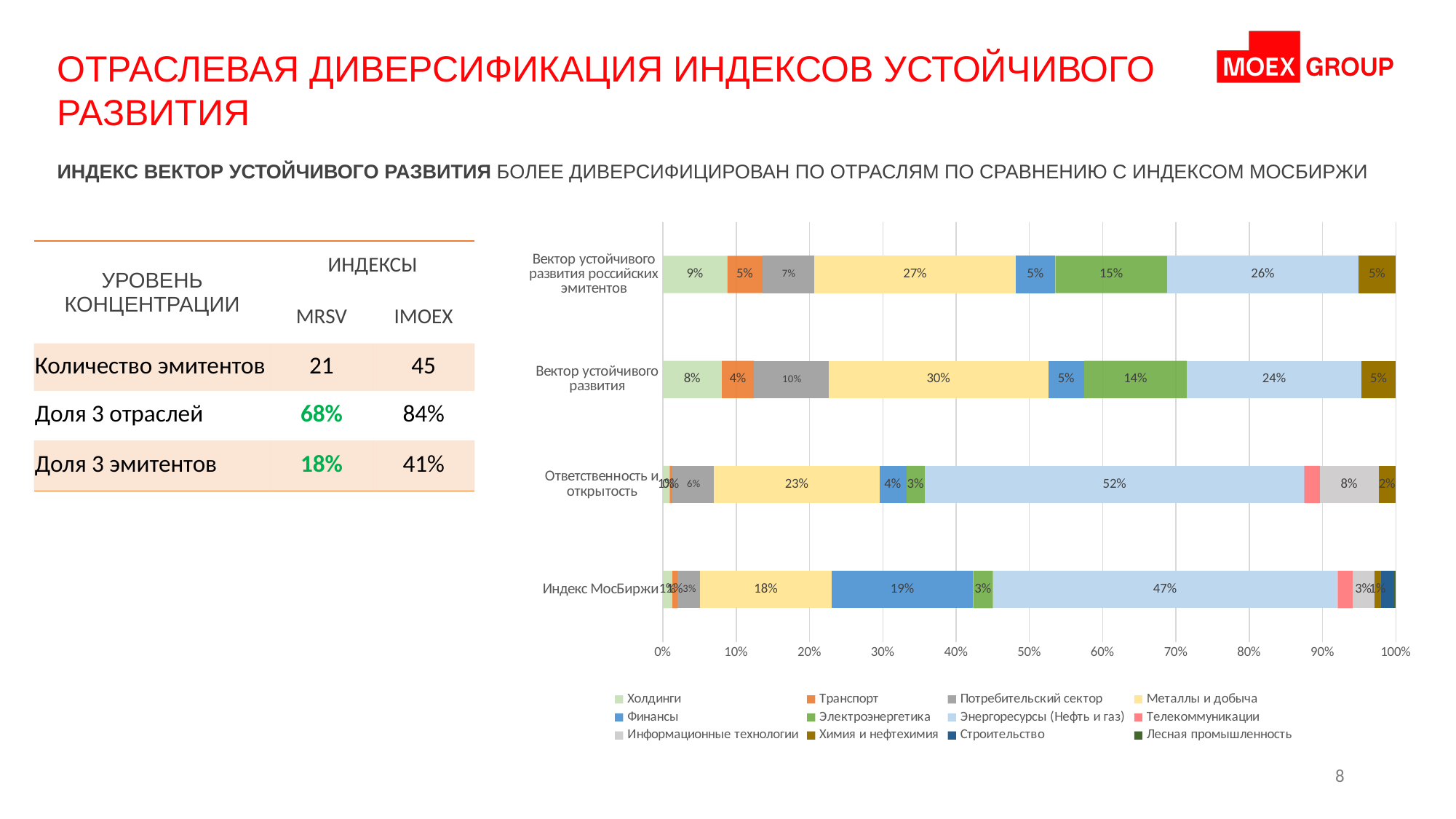
What is the difference between the Финансы share in Индекс МосБиржи and in Вектор устойчивого развития? 14% Which is larger: the Холдинги share in Вектор устойчивого развития российских эмитентов or in Вектор устойчивого развития? Вектор устойчивого развития российских эмитентов What is the share of Металлы и добыча in the Вектор устойчивого развития bar? 30% Which sector is shown in yellow in the chart legend? Металлы и добыча How many index categories (bars) does the chart show? 4 Which index has the largest share of Металлы и добыча? Вектор устойчивого развития What is the share of Энергоресурсы (Нефть и газ) in the Индекс МосБиржи bar? 47% What is the share of Электроэнергетика in the Вектор устойчивого развития российских эмитентов bar? 15% What is the share of Энергоресурсы (Нефть и газ) in the Ответственность и открытость bar? 52% What kind of chart is shown on the slide? Stacked bar chart How many sectors does the chart legend list? 12 Which index has the largest share of Энергоресурсы (Нефть и газ)? Ответственность и открытость